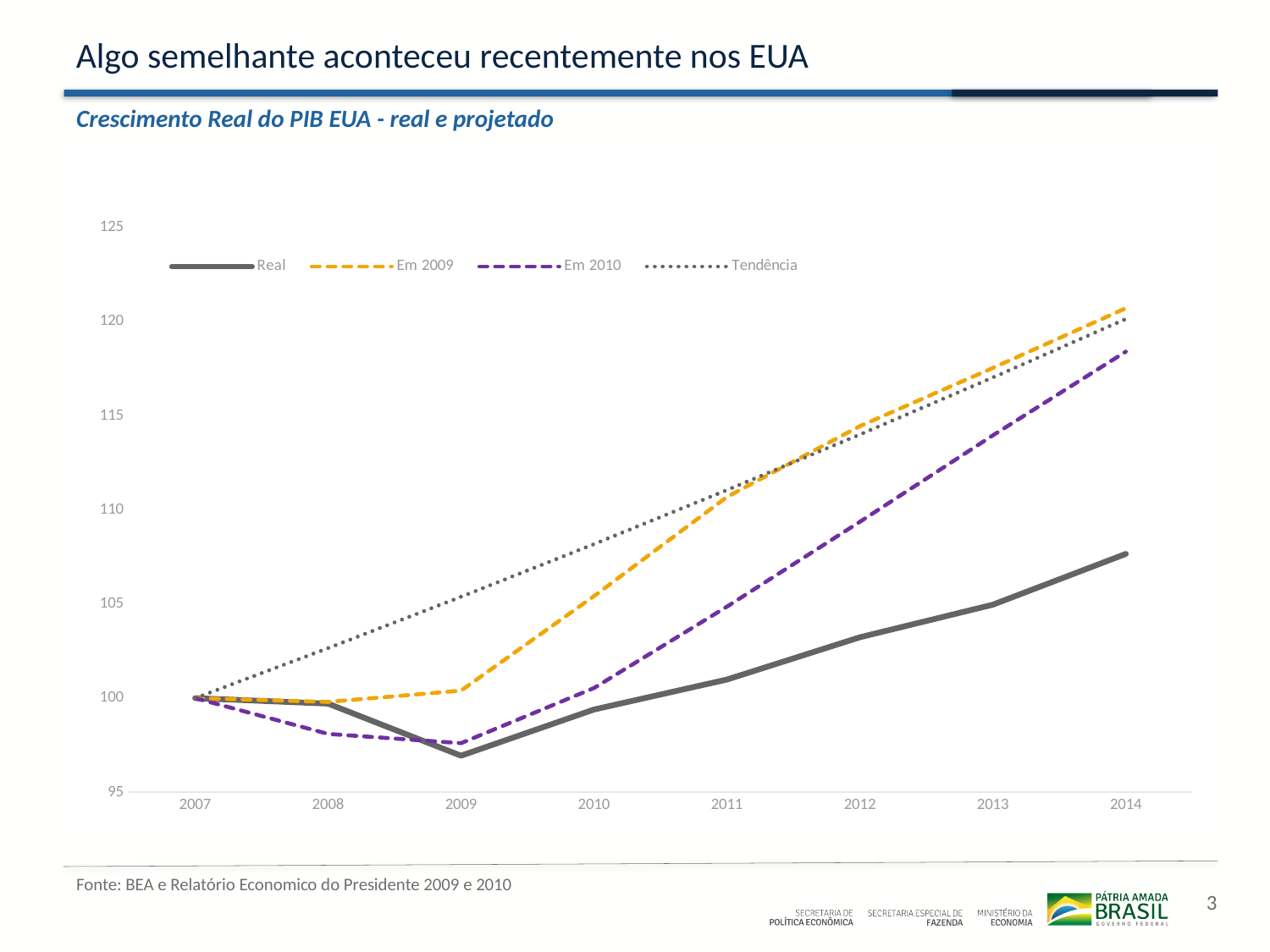
Does the Real series rise or fall from 2009 to 2014? rise Is the value of the Real series in 2009 greater or less than 100? less How many series does the legend list? 4 Is the value of the Em 2009 series in 2011 greater or less than 110? greater How many years are shown on the x axis? 8 Which series has the lowest value in 2014? Real Is the value of the Real series in 2014 greater or less than 105? greater What is the value of the Real series in 2007? 100 What kind of chart is shown on the slide? line chart What is the title of the chart? Crescimento Real do PIB EUA - real e projetado In 2012, which is larger: the Em 2010 series or the Real series? Em 2010